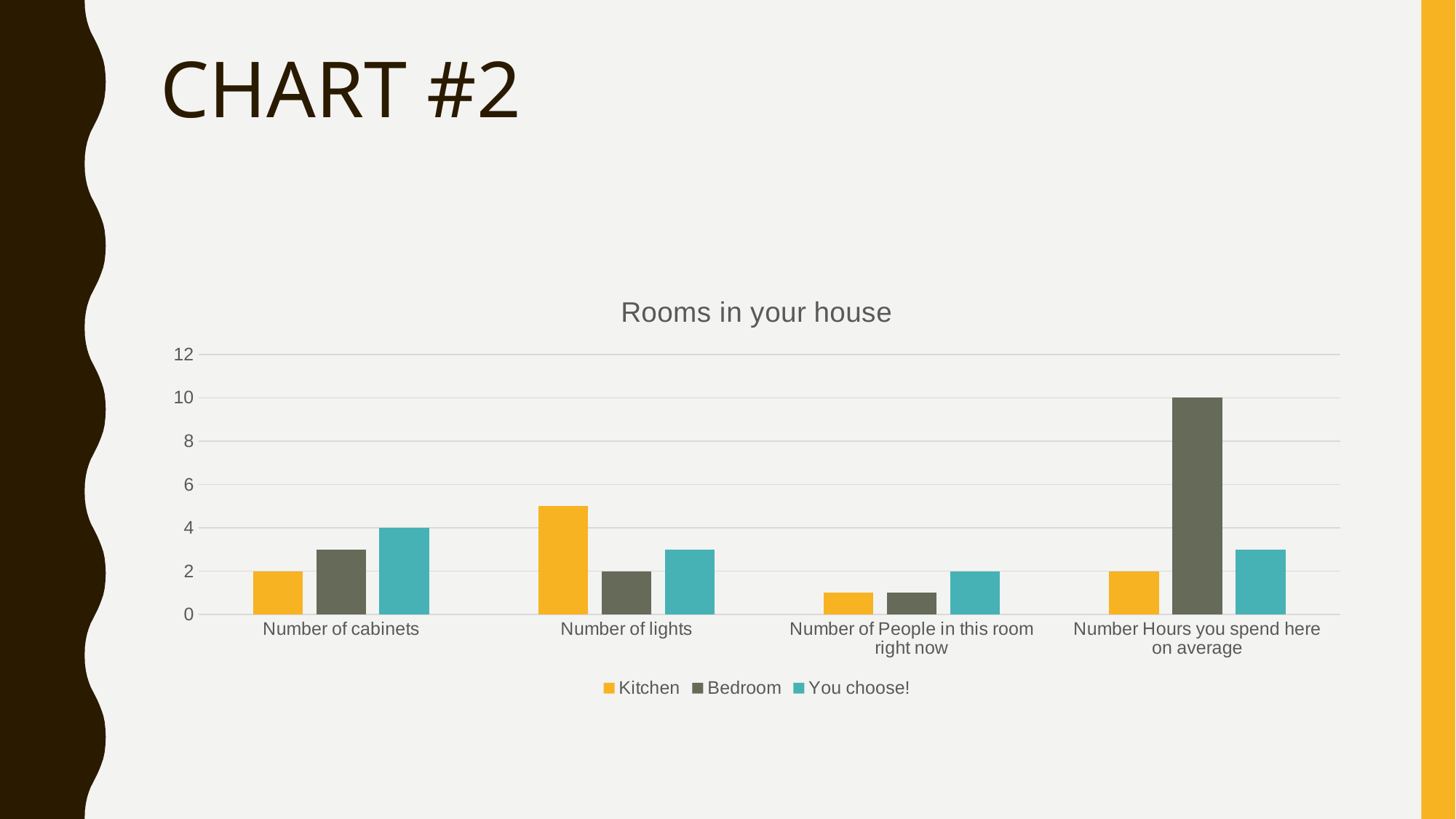
What is the difference between the Bedroom and Kitchen values for Number Hours you spend here on average? 8 What is the title of the chart? Rooms in your house What is the You choose! value for Number of cabinets? 4 What is the Bedroom value for Number of lights? 2 How many series does the legend list? 3 Which is larger for Number of cabinets: the Kitchen value or the You choose! value? You choose! Is the Kitchen value for Number of lights greater or less than 4? greater What is the Kitchen value for Number of cabinets? 2 What is the Bedroom value for Number Hours you spend here on average? 10 How many categories are shown on the x axis? 4 Which series has the highest value for Number Hours you spend here on average? Bedroom What type of chart is shown on the slide? Bar chart